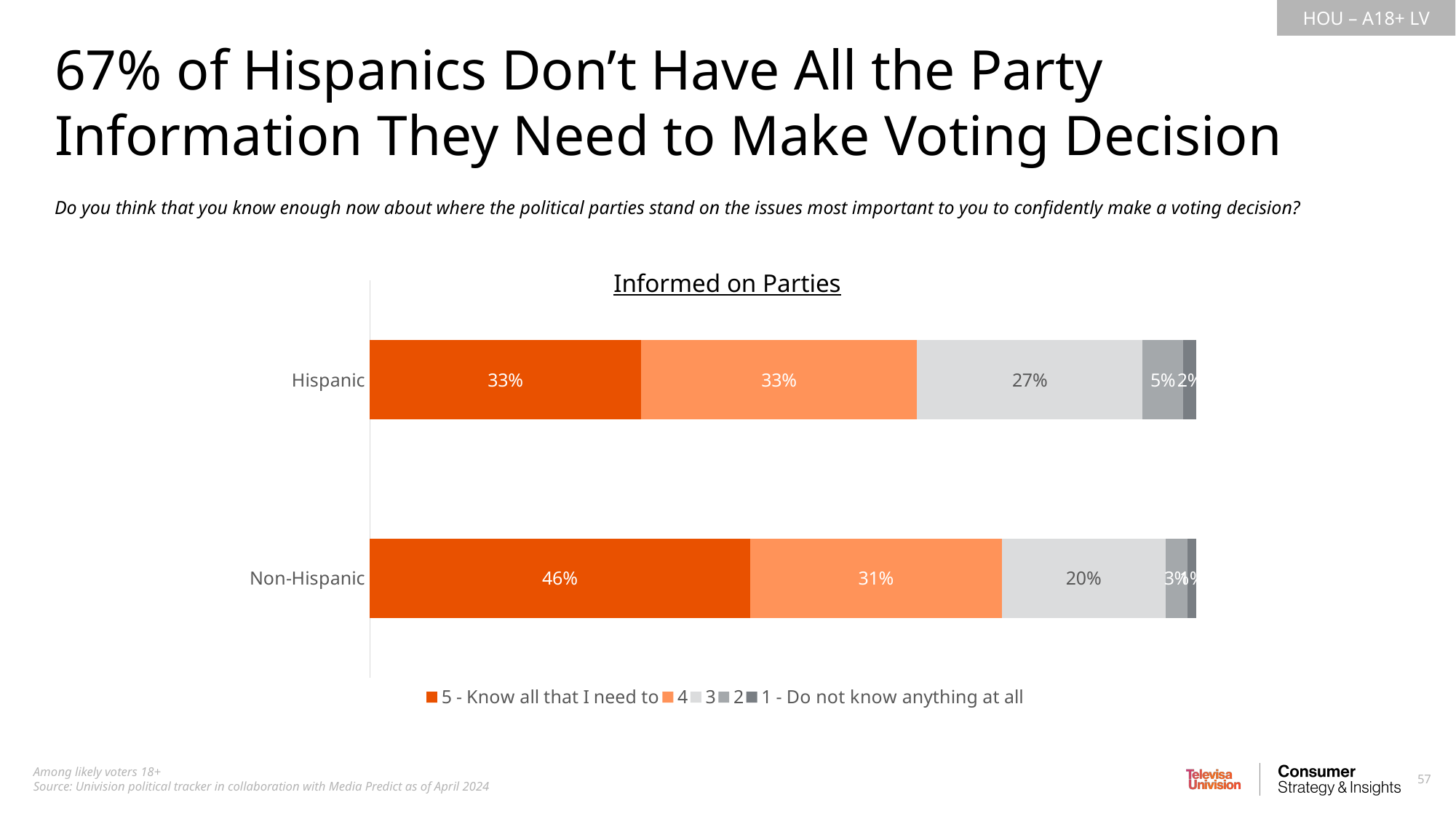
What is the value of the '2' segment for Hispanic? 5% How many series does the legend list? 5 What percentage of Hispanics answered '5 - Know all that I need to'? 33% How many categories are plotted on the chart? 2 What is the chart's title? Informed on Parties What kind of chart is shown on the slide? Stacked bar chart What is the difference between the '5 - Know all that I need to' values for Non-Hispanic and Hispanic? 13% Which category has the larger '5 - Know all that I need to' share, Hispanic or Non-Hispanic? Non-Hispanic What is the value of the '3' segment for Hispanic? 27% What percentage of Non-Hispanics answered '5 - Know all that I need to'? 46% What is the value of the '4' segment for Non-Hispanic? 31% What is the difference between the '3' values for Hispanic and Non-Hispanic? 7%